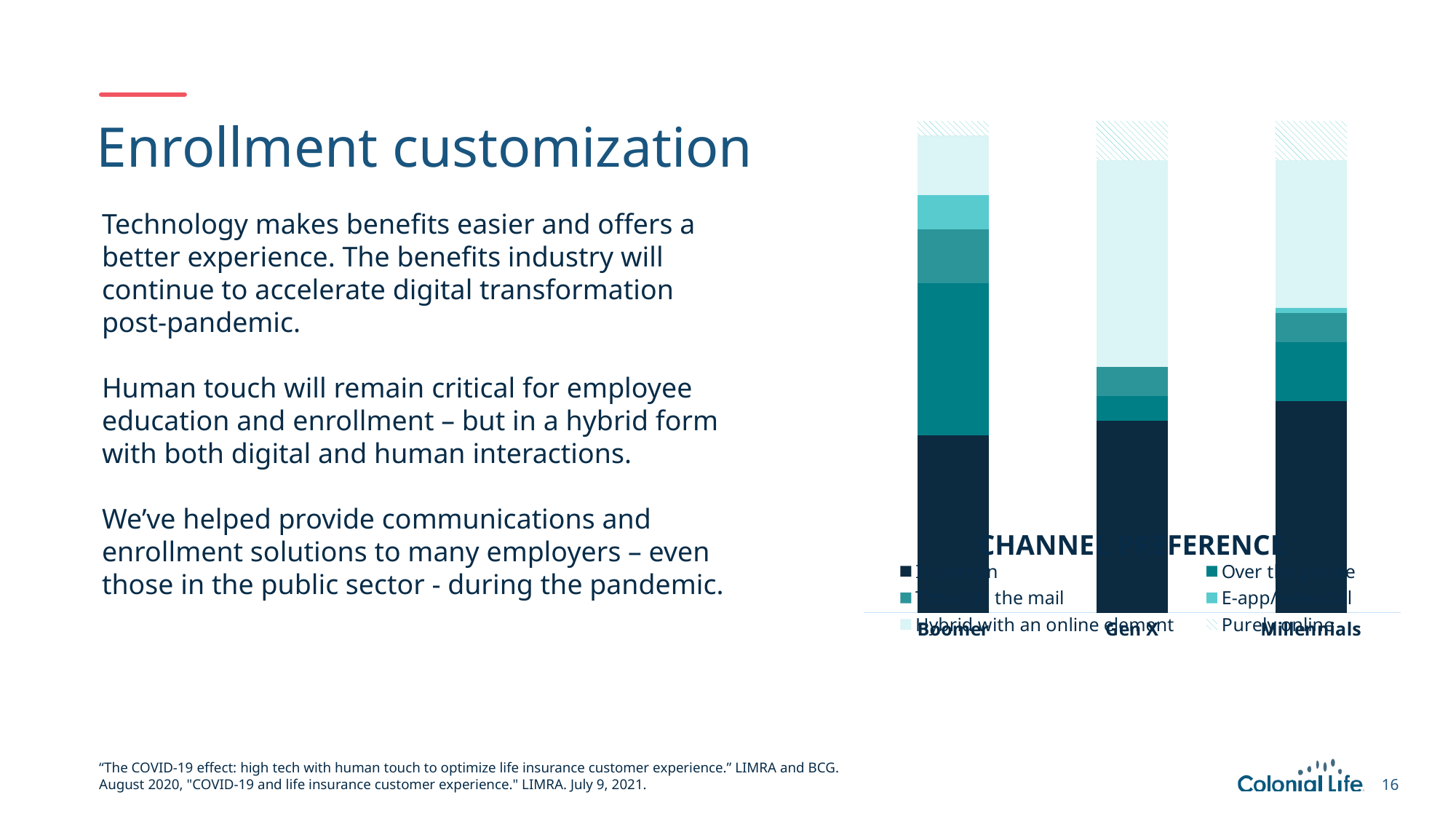
What are the three category labels on the x axis of the chart? Boomer, Gen X, Millennials How many series does the chart's legend list? 6 Is the 'Hybrid with an online element' segment larger for Gen X or for Boomer? Gen X How many categories (generations) are plotted along the x axis of the chart? 3 Which category has the largest 'Hybrid with an online element' segment? Gen X Which category has the smallest 'Purely online' segment? Boomer Which category has the largest second-from-bottom (teal) segment? Boomer What kind of chart is shown on the slide? stacked bar chart Is the 'Hybrid with an online element' segment larger for Millennials or for Boomer? Millennials Which category has the smallest 'Hybrid with an online element' segment? Boomer Which legend entry is shown with a hatched pattern? Purely online Which category has the largest bottom (dark navy) segment? Millennials